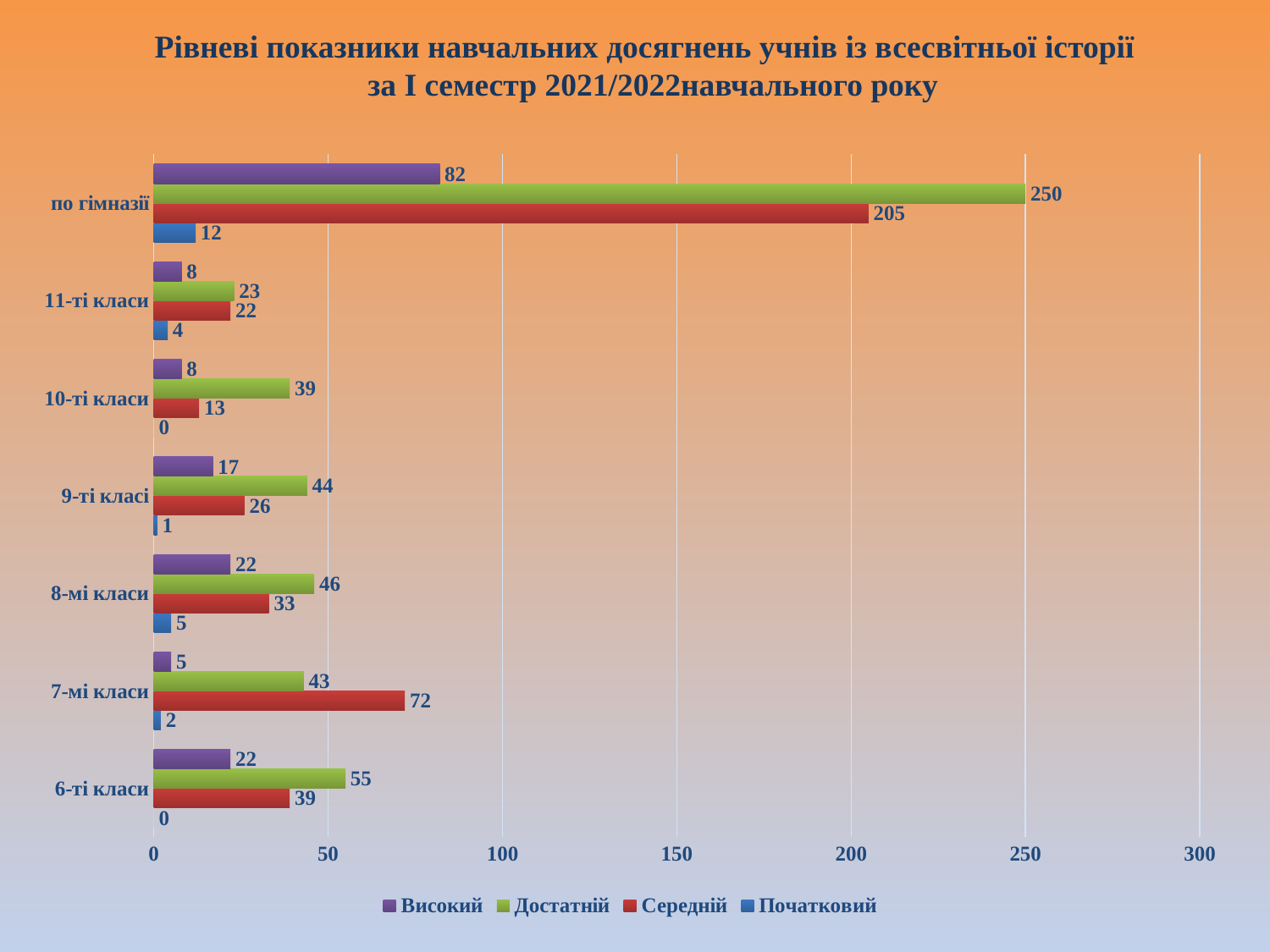
What is the difference between Достатній and Середній for по гімназії? 45 What is the value of Високий for 6-ті класи? 22 Which category has the highest value for Середній? по гімназії What colour represents the Достатній series? green What kind of chart is shown on the slide? bar chart How many series does the legend list? 4 What is the value of Початковий for 9-ті класі? 1 Which is larger for 7-мі класи: Достатній or Середній? Середній Among the class categories (excluding по гімназії), which has the lowest value for Високий? 7-мі класи What is the value of Середній for 7-мі класи? 72 What is the value of Достатній for по гімназії? 250 How many categories are shown on the chart? 7